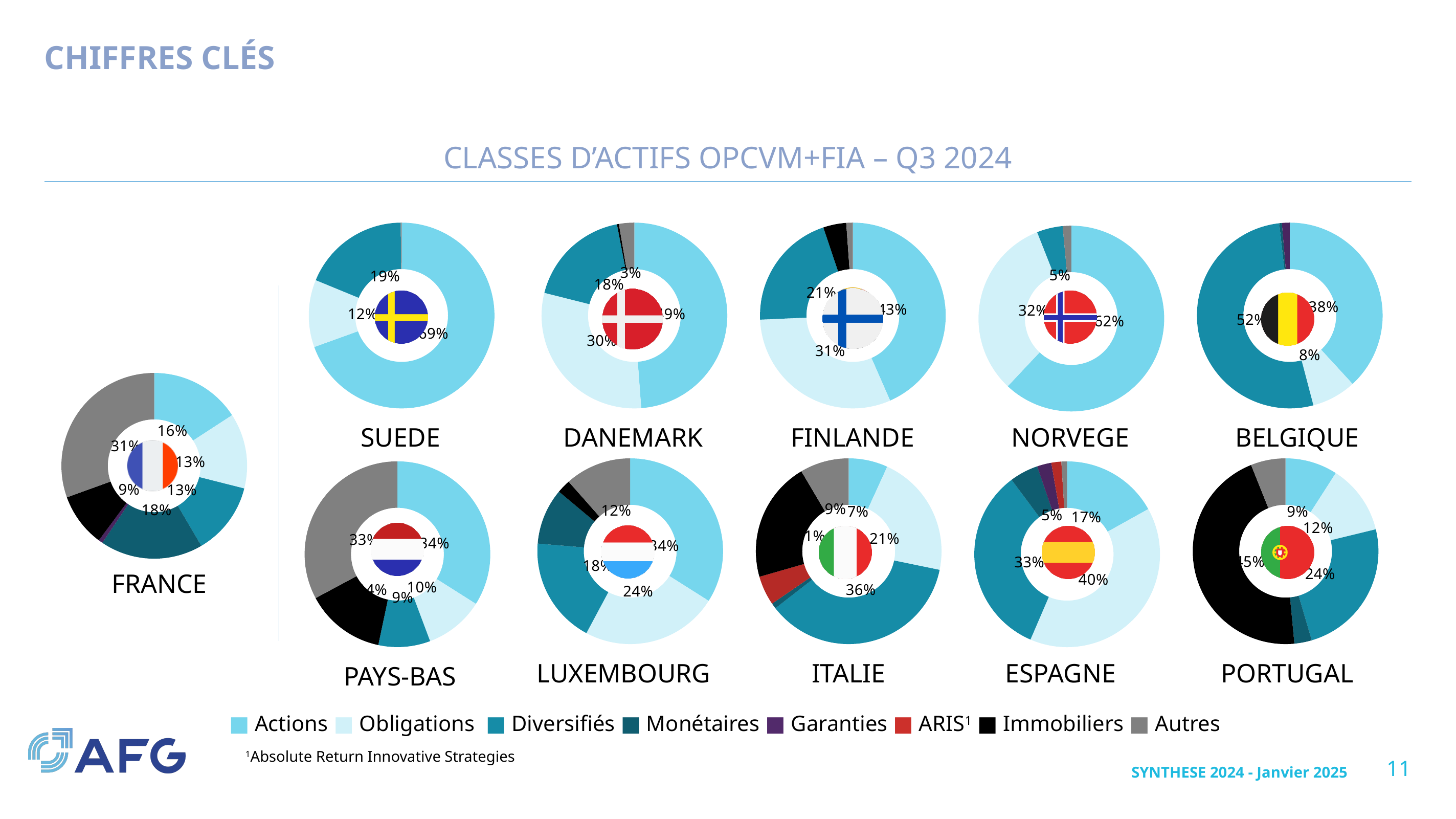
In the PORTUGAL chart, what share is labelled for the Immobiliers (black) slice? 45% What is the title of the chart group on the slide? CLASSES D'ACTIFS OPCVM+FIA – Q3 2024 In the SUEDE chart, what is the largest labelled share? 69% In the DANEMARK chart, what is the difference between the Actions share (49%) and the Obligations share (30%)? 19% In the NORVEGE chart, what share is labelled for the Actions (light blue) slice? 62% How many country charts are shown on the slide? 11 In the ESPAGNE chart, which is larger: the Obligations slice or the Diversifiés slice? Obligations In the BELGIQUE chart, what share is labelled for the Diversifiés (teal) slice? 52% What kind of chart is used for each country on the slide? Pie (donut) chart In the LUXEMBOURG chart, what is the smallest labelled share? 12% How many series does the legend at the bottom of the slide list? 8